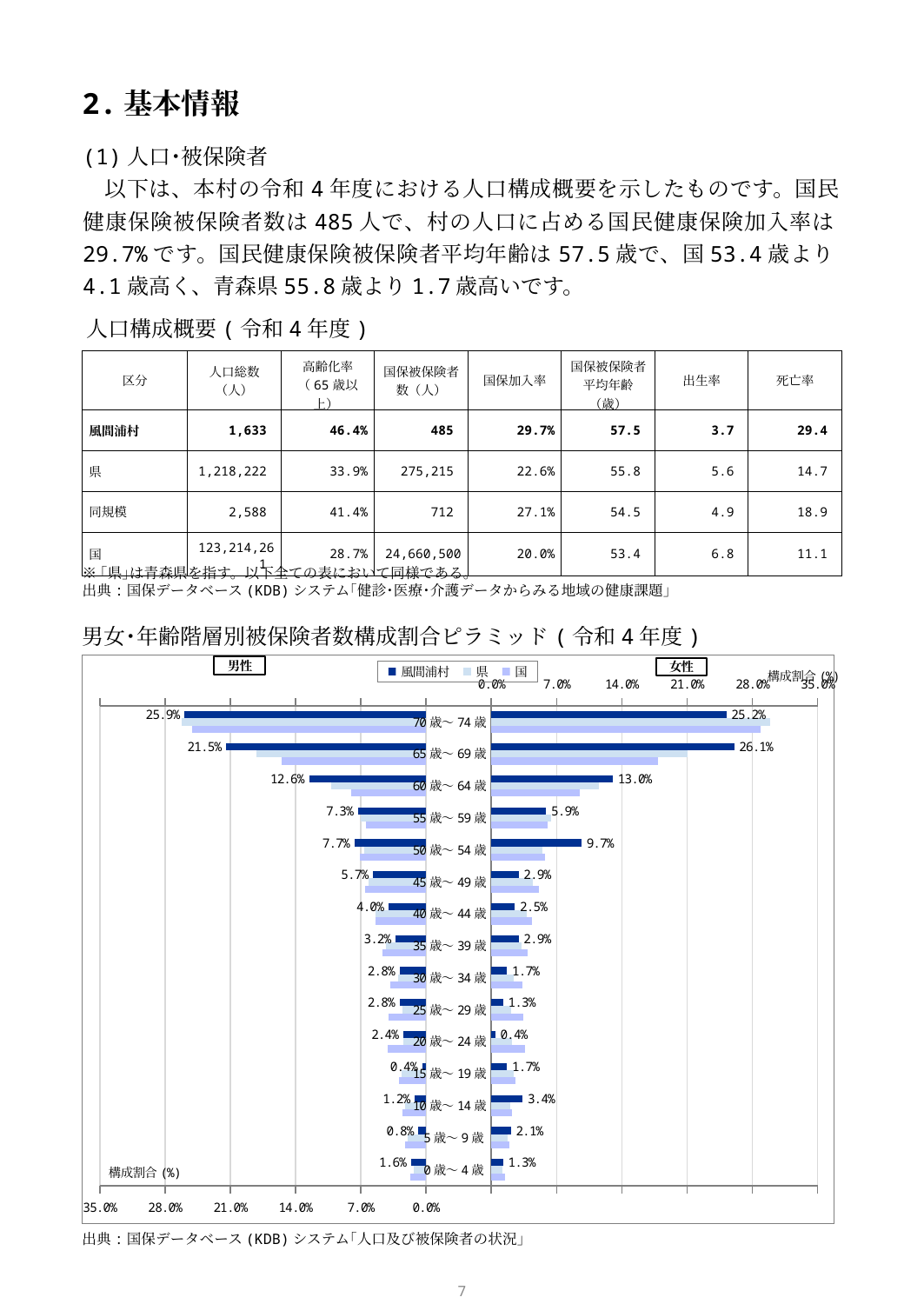
In the population pyramid chart, what is the 風間浦村 value for males aged 70歳～74歳? 25.9% In the population pyramid chart, what is the 風間浦村 value for females aged 50歳～54歳? 9.7% In the population pyramid chart, is the 風間浦村 value larger for males or females aged 10歳～14歳? females Which series in the population pyramid chart is drawn in the darkest blue? 風間浦村 In the population pyramid chart, what is the difference between the 風間浦村 male and female values for 60歳～64歳? 0.4% In the population pyramid chart, which age group has the lowest 風間浦村 value on the male side? 15歳～19歳 How many age groups are shown on the population pyramid chart? 15 What kind of chart is the 男女・年齢階層別被保険者数構成割合ピラミッド chart? bar chart In the population pyramid chart, which age group has the highest 風間浦村 value on the male side? 70歳～74歳 How many series does the legend of the population pyramid chart list? 3 In the population pyramid chart, what is the 風間浦村 value for females aged 65歳～69歳? 26.1% In the population pyramid chart, is the 風間浦村 value for males aged 65歳～69歳 greater or less than 14.0%? greater